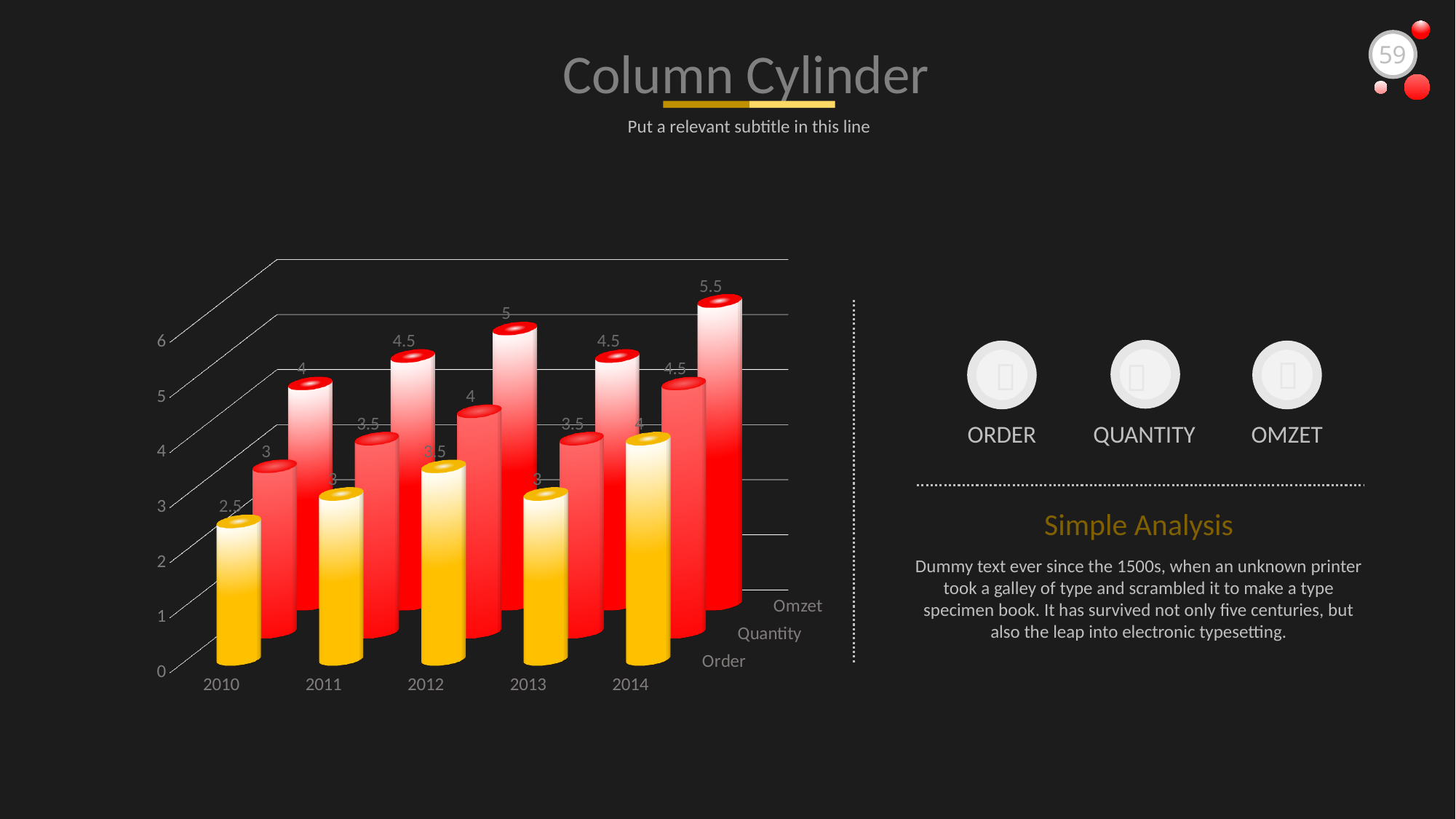
What is the Order value for 2014? 4 What is the Quantity value for 2011? 3.5 Which is larger, the Quantity value for 2012 or the Quantity value for 2013? 2012 What is the Omzet value for 2012? 5 What kind of chart is shown on the slide? bar chart How many data series does the chart show? 3 Which year has the highest Omzet value? 2014 What is the title of the slide containing the chart? Column Cylinder How many years are shown on the x axis? 5 Which year has the lowest Order value? 2010 What is the Order value for 2010? 2.5 What is the difference between the Omzet value for 2014 and the Omzet value for 2010? 1.5